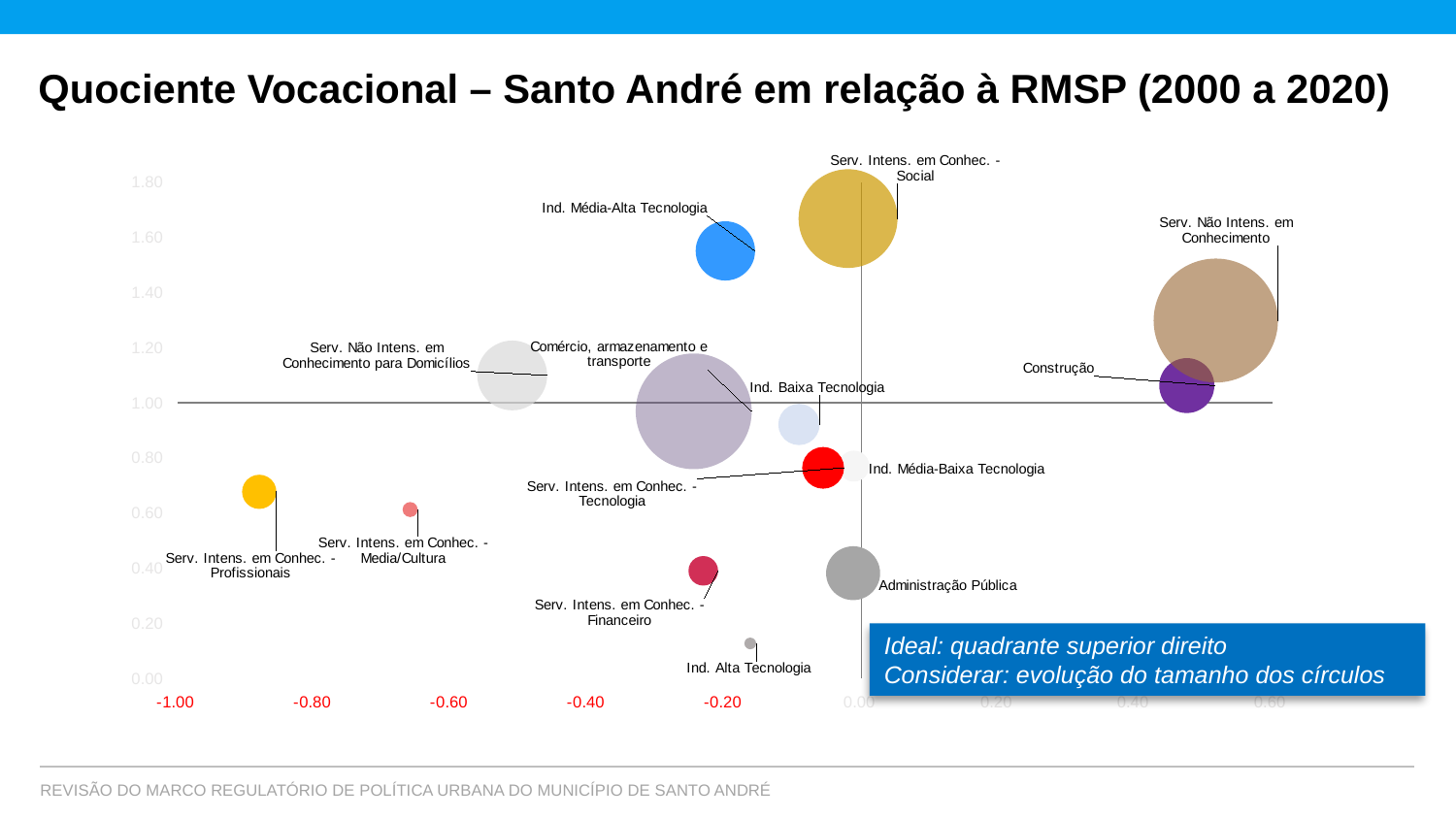
What kind of chart is shown on the slide? bubble chart Which bubble is positioned higher on the vertical axis, Construção or Serv. Não Intens. em Conhecimento? Serv. Não Intens. em Conhecimento Which sector's bubble is positioned highest on the vertical axis? Serv. Intens. em Conhec. - Social Is the vertical-axis value for Administração Pública greater or less than 0.60? less Is the vertical-axis value for Ind. Alta Tecnologia greater or less than 0.20? less According to the text box on the chart, which quadrant is described as ideal? quadrante superior direito Is the vertical-axis value for Serv. Intens. em Conhec. - Social greater or less than 1.40? greater What is the title of the chart? Quociente Vocacional – Santo André em relação à RMSP (2000 a 2020) Which sector's bubble is positioned lowest on the vertical axis? Ind. Alta Tecnologia Which sector's bubble is positioned furthest to the left on the horizontal axis? Serv. Intens. em Conhec. - Profissionais Which sector's bubble is positioned furthest to the right on the horizontal axis? Serv. Não Intens. em Conhecimento